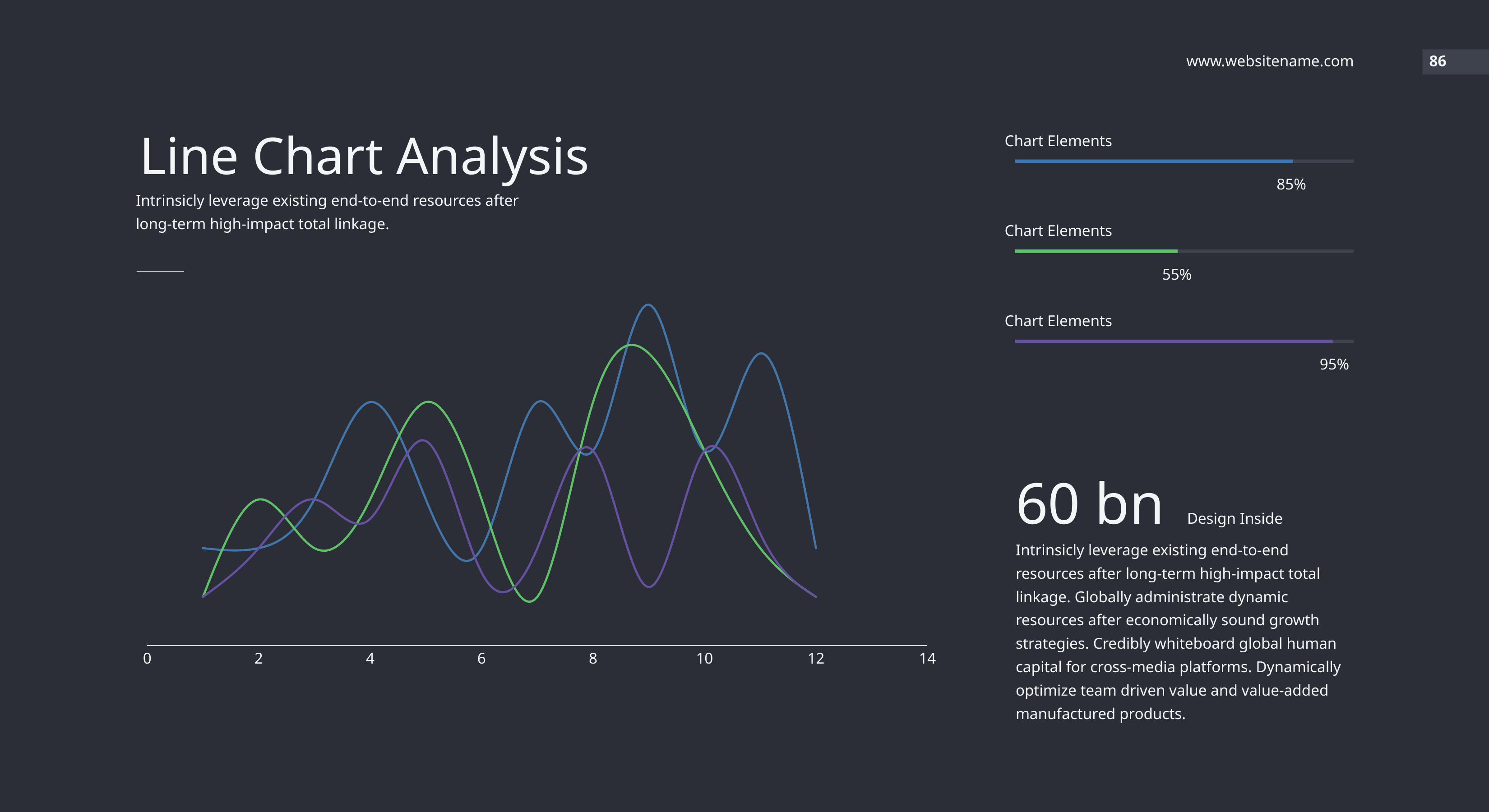
In the progress bars on the right, what is the value of the top (blue) Chart Elements bar? 85% In the line chart, does the blue line rise or fall between x = 11 and x = 12? Fall What is the title of the line chart slide? Line Chart Analysis How many tick labels are shown on the x axis of the line chart? 8 In the progress bars on the right, which bar has the highest value? The bottom (purple) bar, 95% What is the highest value labelled on the x axis of the line chart? 14 In the progress bars on the right, what is the value of the middle (green) Chart Elements bar? 55% In the line chart, does the green line rise or fall between x = 9 and x = 12? Fall In the progress bars on the right, what is the difference between the bottom bar (95%) and the middle bar (55%)? 40 percentage points Which coloured line in the line chart reaches the highest peak? Blue What kind of chart is shown on the left of the slide? Line chart How many lines are plotted in the line chart? 3